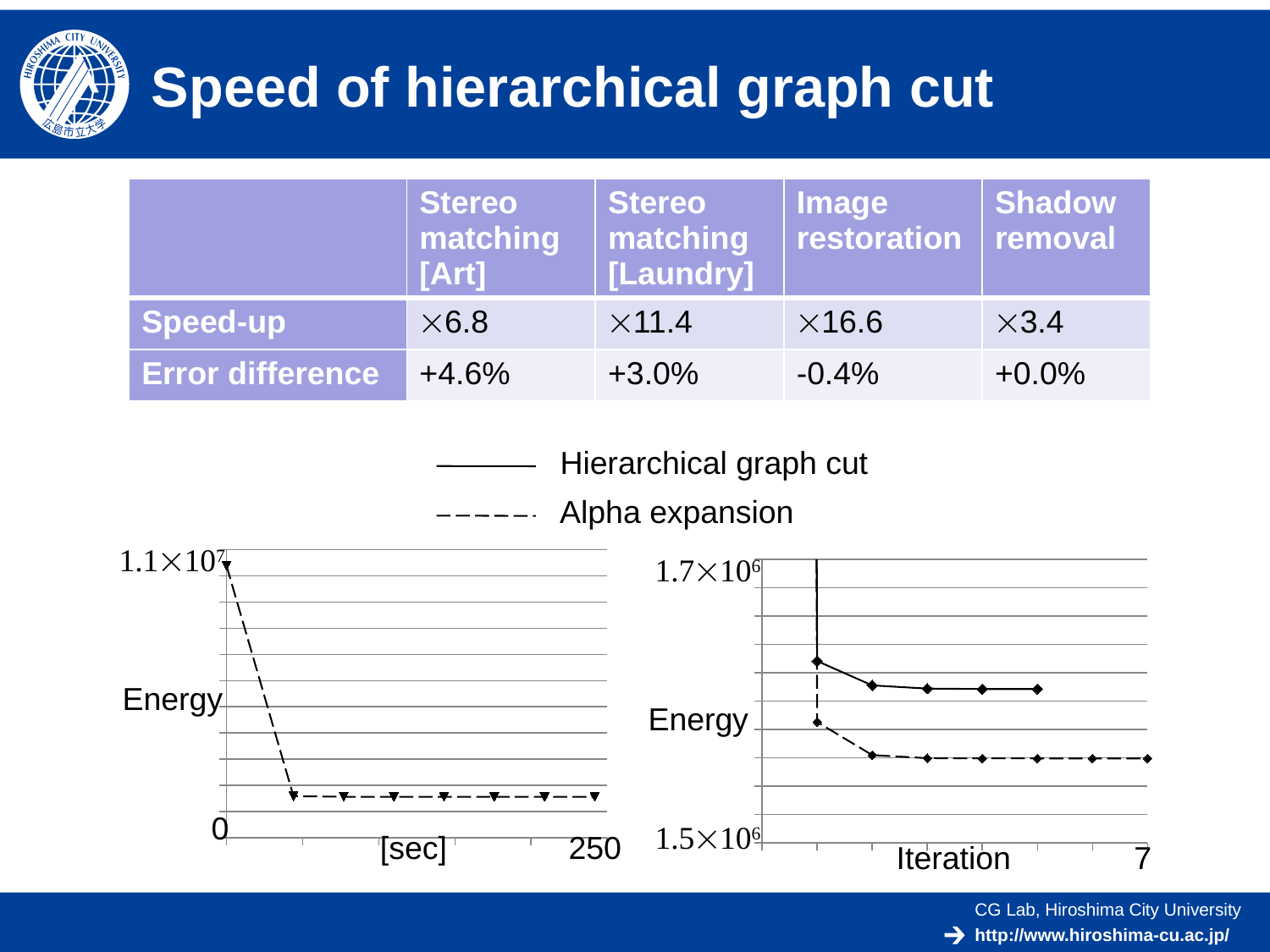
In the right chart, which series has the higher energy at its final iteration, Hierarchical graph cut or Alpha expansion? Hierarchical graph cut In the right chart, how many data points are plotted on the Alpha expansion (dashed) line? 7 What kind of chart is the right chart (Energy vs Iteration)? line chart In the left chart, does the energy rise or fall as time in seconds increases? fall In the right chart, what is the value at the top of the y axis? 1.7×10^6 What is the label of the x axis of the right chart? Iteration What kind of chart is the left chart (Energy vs [sec])? line chart How many series does the legend above the charts list? 2 In the right chart, what is the value at the bottom of the y axis? 1.5×10^6 Which series is drawn with a dashed line according to the legend? Alpha expansion In the left chart, what is the maximum value shown on the x axis? 250 In the right chart, is the final energy of the Hierarchical graph cut series greater or less than 1.7×10^6? less